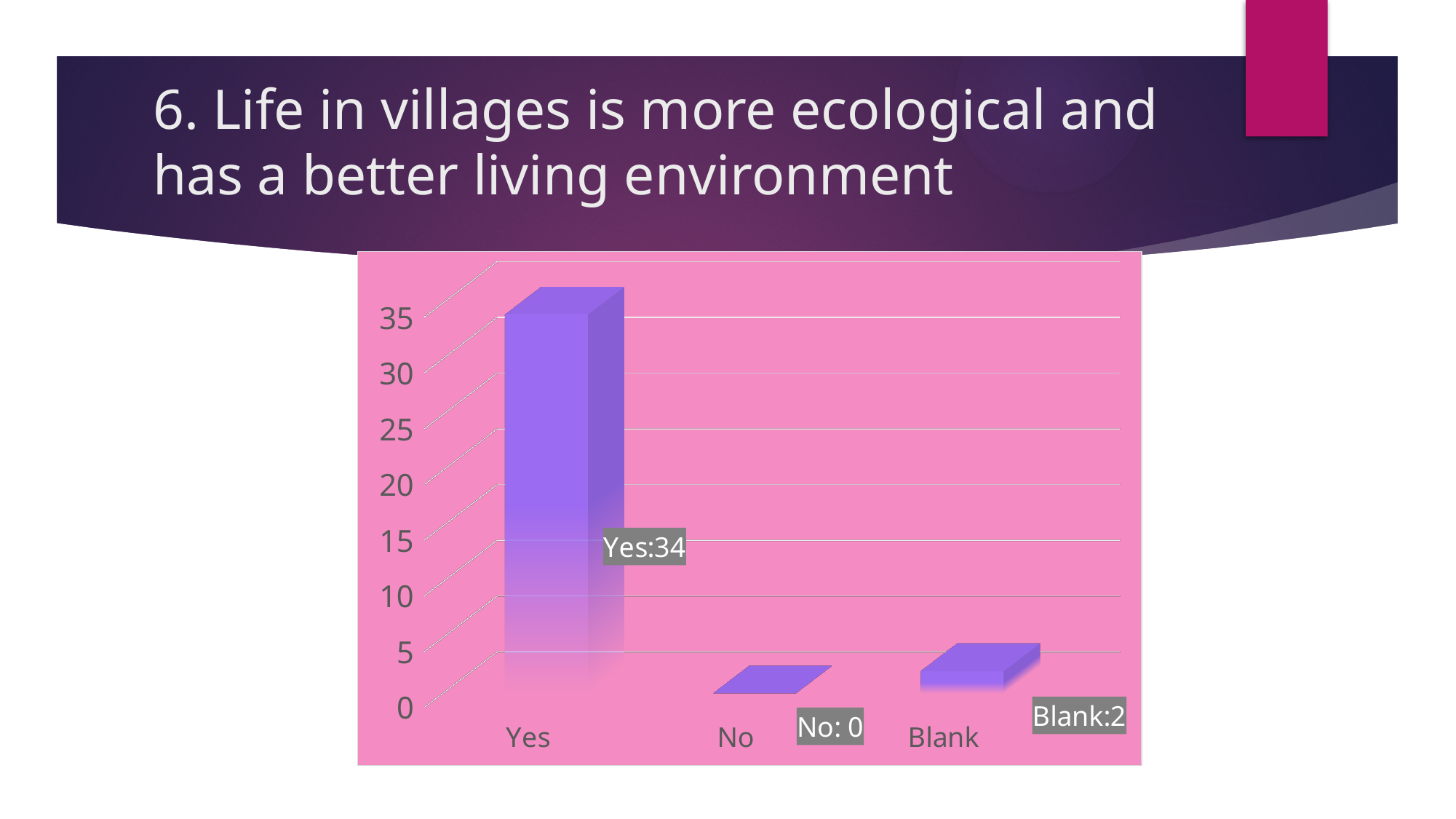
What kind of chart is shown on the slide? bar chart Which category has the lowest value? No Which category has the highest value? Yes What is the title of the slide containing the chart? 6. Life in villages is more ecological and has a better living environment How many categories are shown on the x axis? 3 What is the difference between the values for Yes and Blank? 32 What is the value for Blank? 2 What is the value for No? 0 Which is larger, the value for Blank or the value for No? Blank What is the value for Yes? 34 What is the total of the values for Yes, No and Blank? 36 Is the value for Yes greater or less than 30? greater